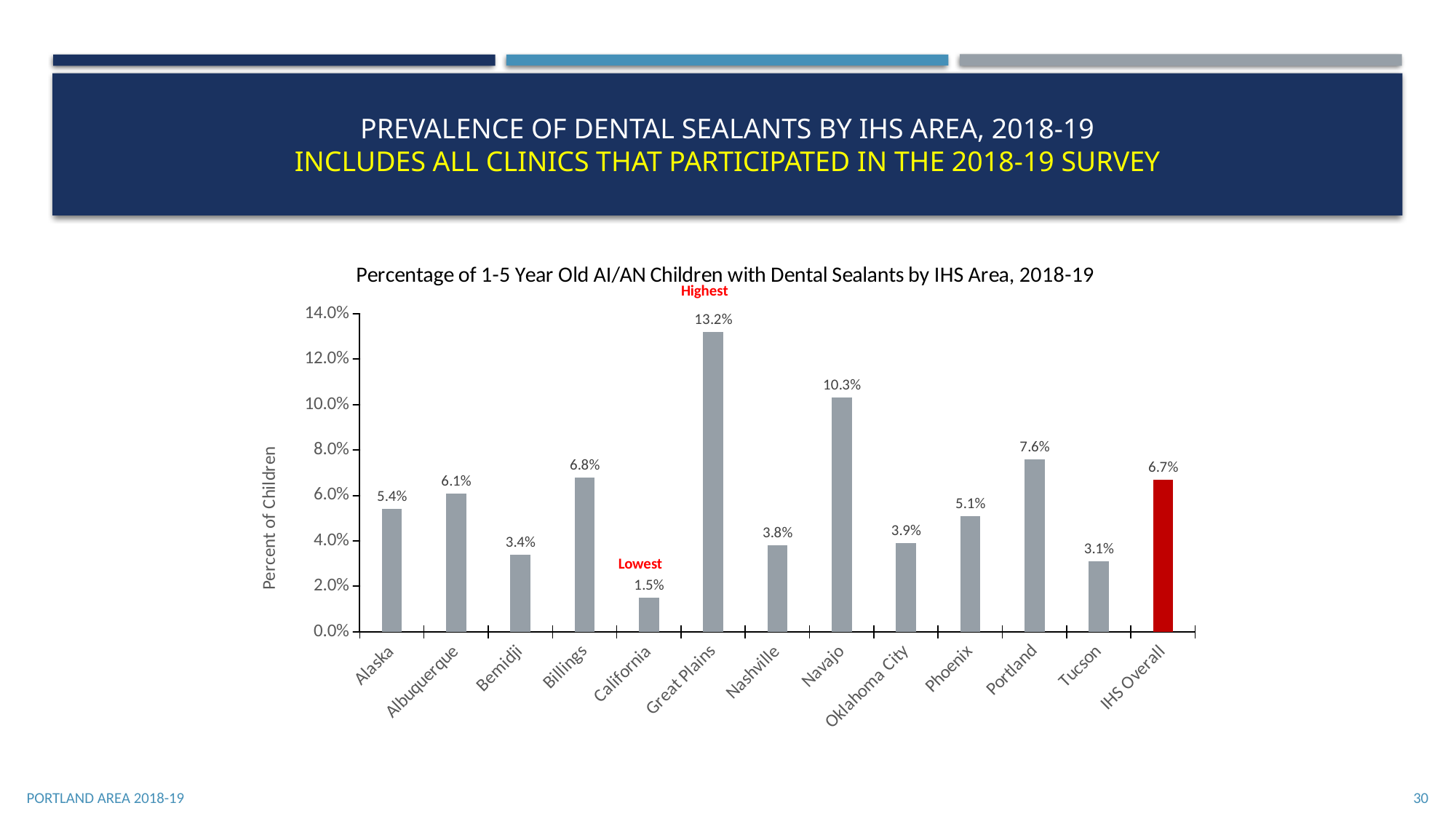
What kind of chart is shown on the slide? Bar chart How many categories are shown on the x axis? 13 Is the value for Navajo greater or less than 10.0%? greater What is the value for IHS Overall? 6.7% Which IHS area has the lowest percentage of children with dental sealants? California Which is larger, the value for Billings or the value for Albuquerque? Billings What is the value for Portland? 7.6% Which bar is coloured red instead of grey? IHS Overall What is the difference between the values for Portland and IHS Overall? 0.9% Which IHS area has the highest percentage of children with dental sealants? Great Plains What is the difference between the values for Great Plains and Navajo? 2.9% What is the value for Great Plains? 13.2%